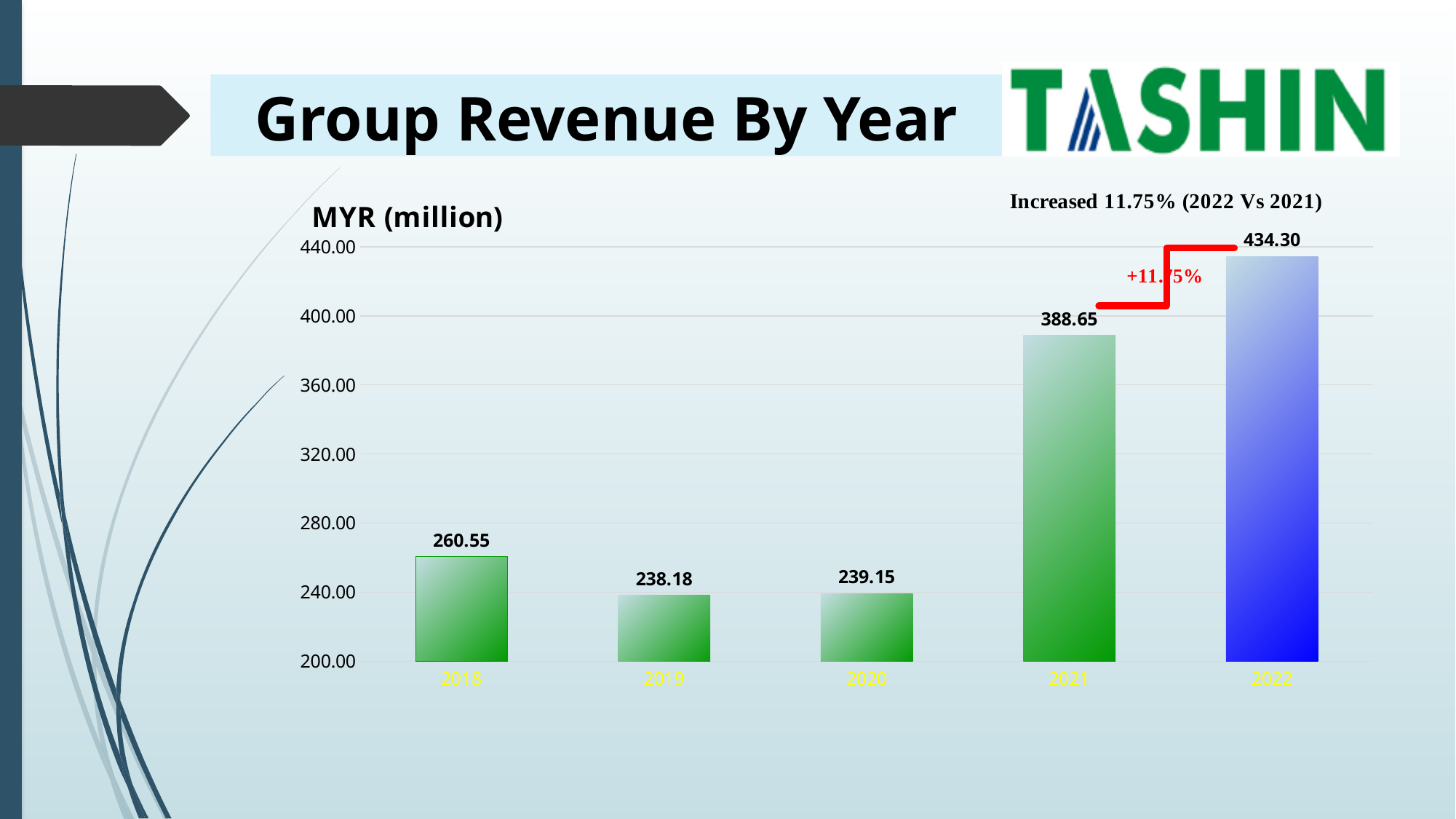
What is the group revenue for 2022? 434.30 What kind of chart is shown on the slide? bar chart Which year has the lowest group revenue? 2019 What is the difference in group revenue between 2022 and 2021? 45.65 What is the difference in group revenue between 2018 and 2019? 22.37 Is the group revenue for 2021 greater or less than 400.00? less What is the group revenue for 2018? 260.55 What is the group revenue for 2021? 388.65 Which year has the highest group revenue? 2022 By what percentage did group revenue increase from 2021 to 2022, according to the slide? 11.75% Which year has higher group revenue, 2018 or 2020? 2018 How many years are shown in the chart? 5